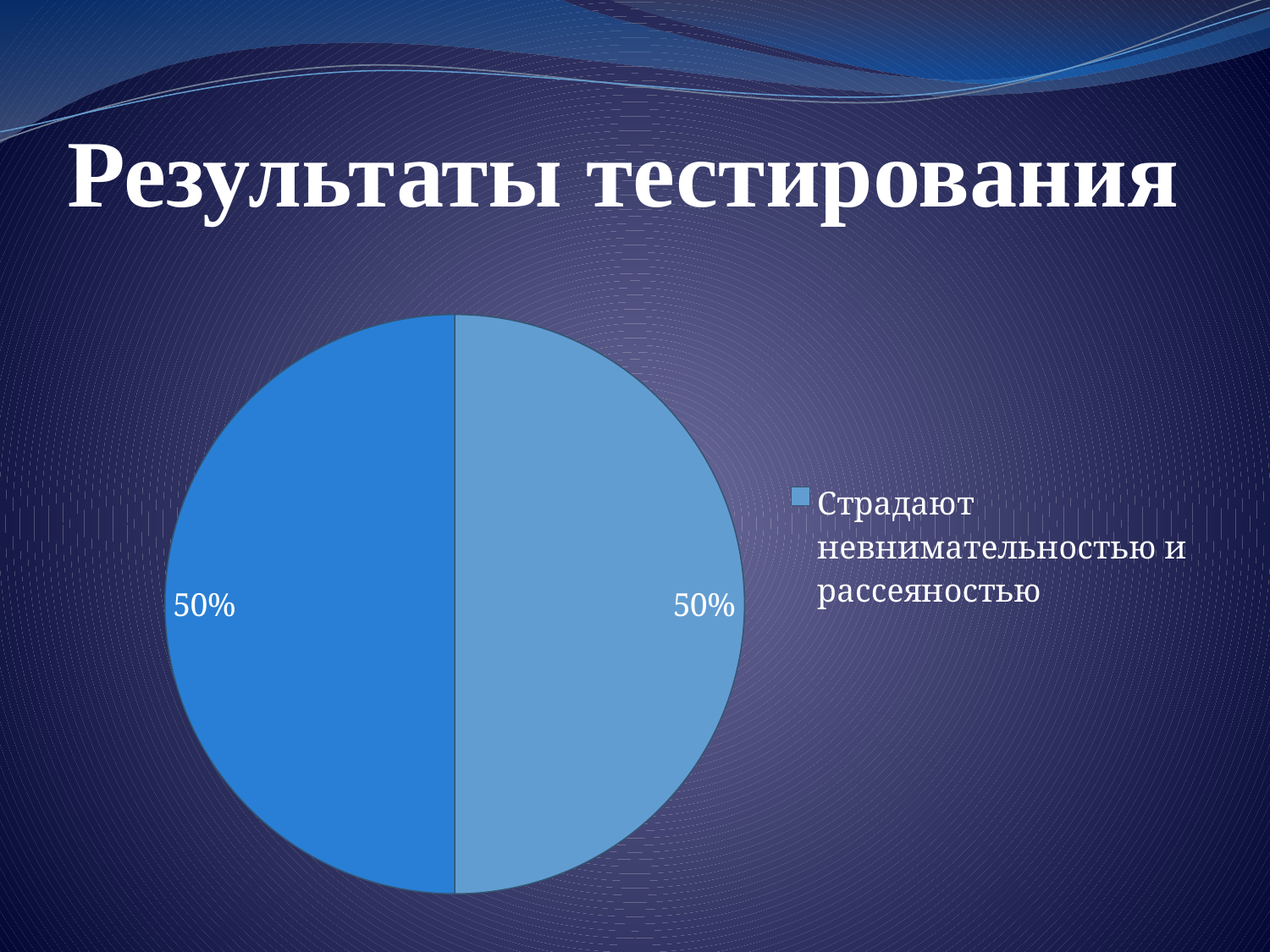
Do the two slices of the pie chart have the same value? yes How many slices does the pie chart have? 2 What kind of chart is shown on the slide? pie chart What value is printed on the right (lighter blue) slice of the pie chart? 50% What share of the pie does the slice labelled "Страдают невнимательностью и рассеяностью" represent? 50% What is the text of the legend entry shown next to the pie chart? Страдают невнимательностью и рассеяностью What value is printed on the left (darker blue) slice of the pie chart? 50% What is the title of the slide containing the pie chart? Результаты тестирования How many entries does the legend of the pie chart list? 1